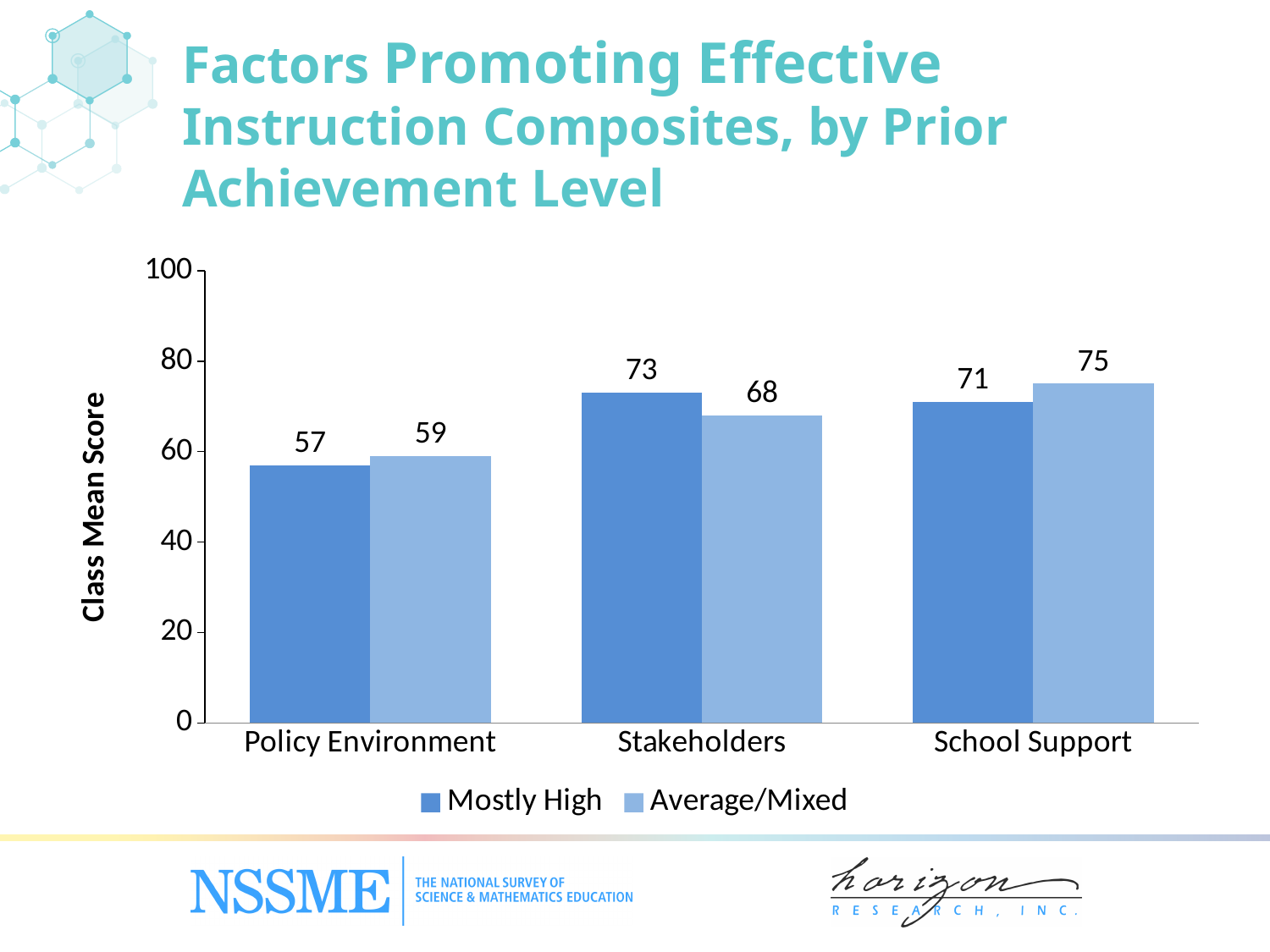
What is the difference between the Average/Mixed scores for School Support and Policy Environment? 16 Which composite has the highest class mean score for Mostly High classes? Stakeholders What is the class mean score for Average/Mixed classes on the Stakeholders composite? 68 On the School Support composite, which group has the higher class mean score, Mostly High or Average/Mixed? Average/Mixed What is the class mean score for Average/Mixed classes on the School Support composite? 75 What kind of chart is shown on the slide? Bar chart Is the Mostly High score for Policy Environment greater or less than 60? less What is the difference between the Mostly High and Average/Mixed scores on the Stakeholders composite? 5 Which composite has the lowest class mean score for Average/Mixed classes? Policy Environment How many series does the legend list? 2 What is the class mean score for Mostly High classes on the Policy Environment composite? 57 How many composites are shown on the x axis? 3